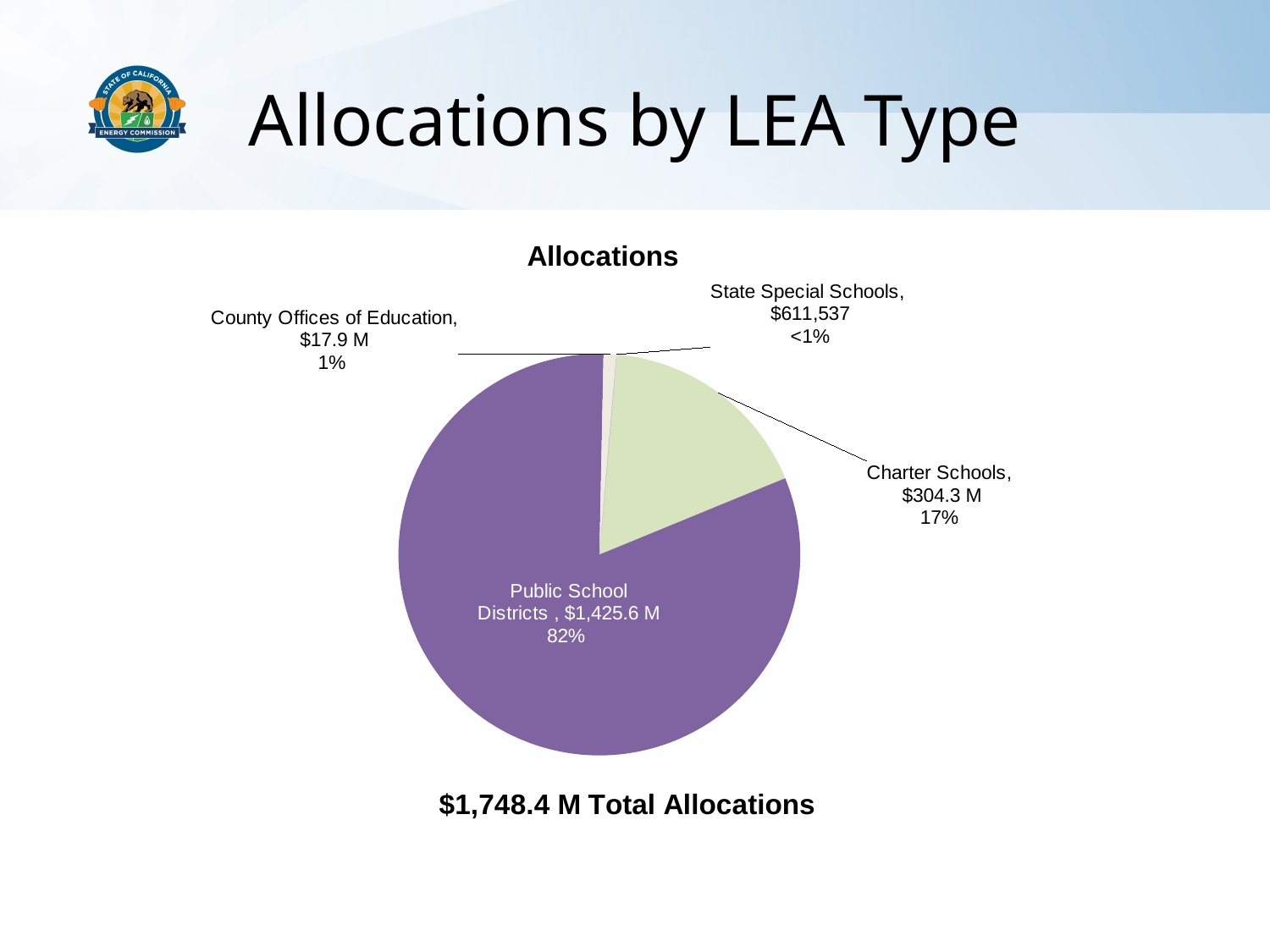
Which has a larger allocation, Charter Schools or County Offices of Education? Charter Schools What share of the pie do Charter Schools represent? 17% How many slices does the pie chart have? 4 What is the allocation amount for County Offices of Education? $17.9 M What is the chart's title? Allocations What type of chart is shown on the slide? Pie chart Which LEA type has the smallest allocation? State Special Schools What share of the pie do Public School Districts represent? 82% What is the allocation amount for State Special Schools? $611,537 What is the allocation amount for Public School Districts? $1,425.6 M Which LEA type has the largest allocation? Public School Districts What is the allocation amount for Charter Schools? $304.3 M